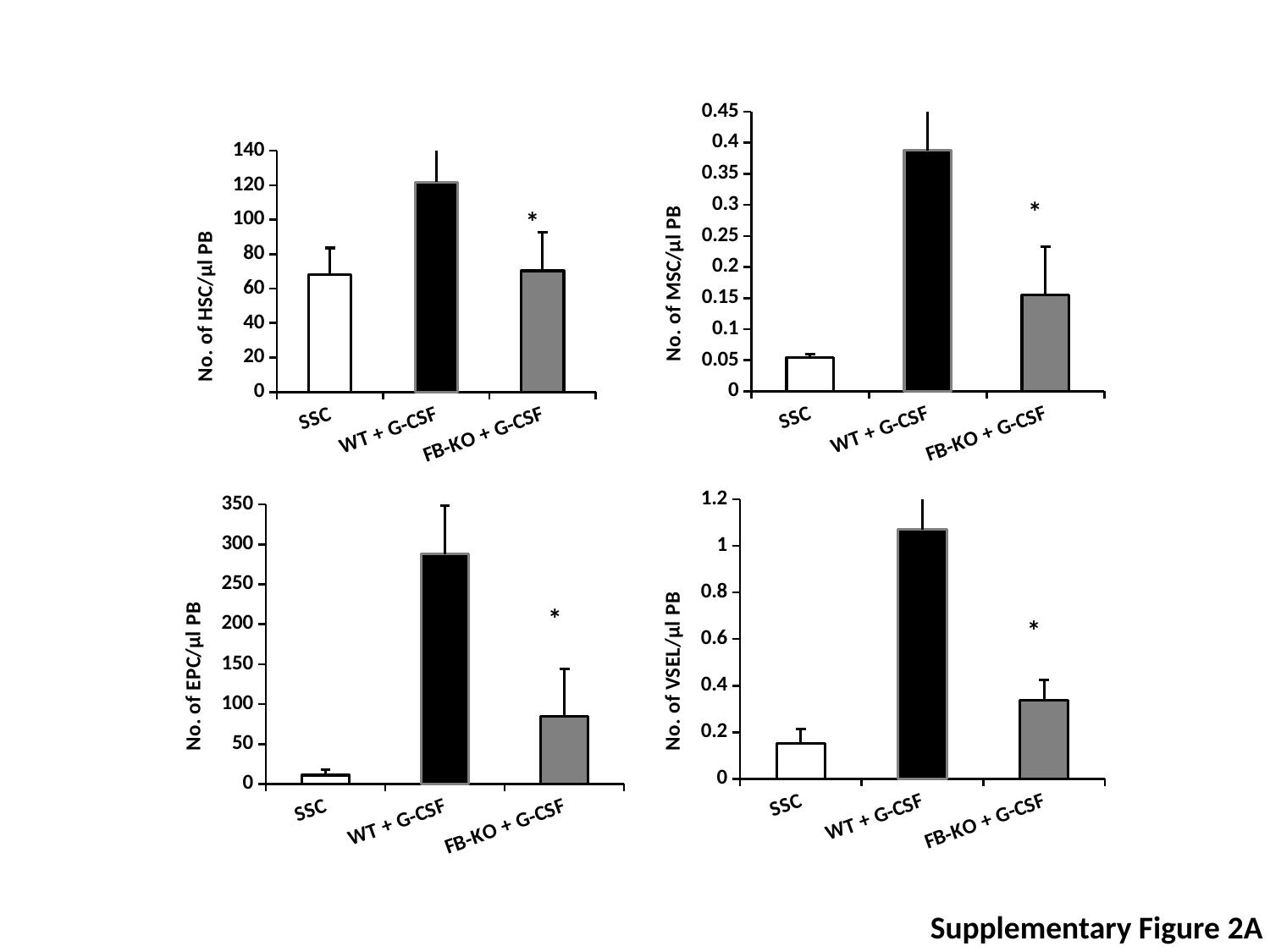
In the top-right chart (No. of MSC/µl PB), is the value for WT + G-CSF greater or less than 0.35? greater In the bottom-left chart (No. of EPC/µl PB), which category has the highest value? WT + G-CSF In the top-left chart (No. of HSC/µl PB), is the value for WT + G-CSF greater or less than 100? greater In the top-right chart (No. of MSC/µl PB), which is larger, the value for FB-KO + G-CSF or the value for SSC? FB-KO + G-CSF In the bottom-right chart (No. of VSEL/µl PB), which is larger, the value for SSC or the value for FB-KO + G-CSF? FB-KO + G-CSF In the bottom-right chart (No. of VSEL/µl PB), is the value for WT + G-CSF greater or less than 1? greater In the top-right chart (No. of MSC/µl PB), which category has the lowest value? SSC How many categories are shown on the x axis of the top-left chart (No. of HSC/µl PB)? 3 How many bar charts are shown on the slide? 4 What kind of chart is the top-left chart (No. of HSC/µl PB)? bar chart In the top-left chart (No. of HSC/µl PB), which category has the highest value? WT + G-CSF